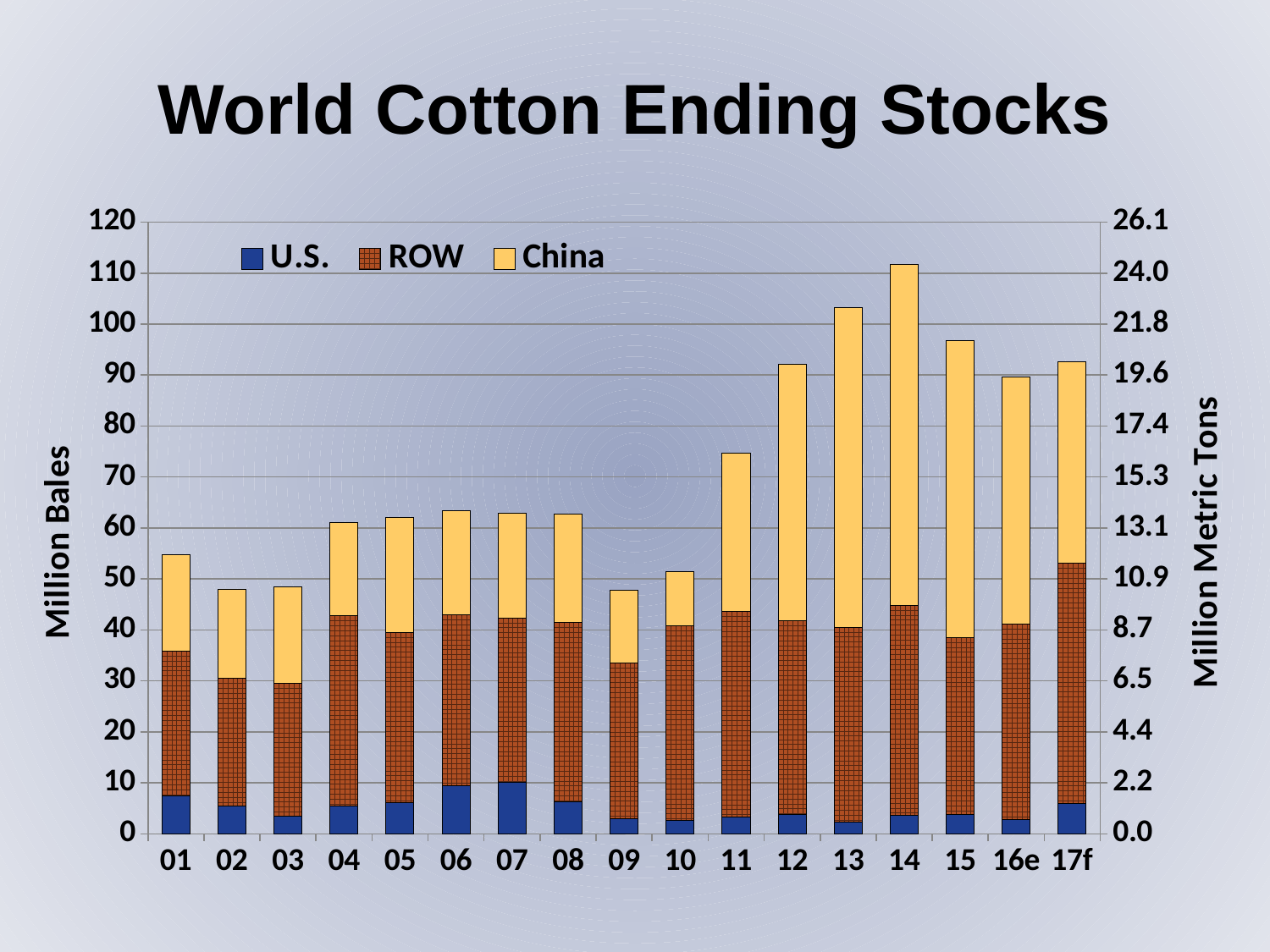
Which year has the highest total ending stocks? 14 Which year has the larger total ending stocks, 11 or 12? 12 Is the total ending stocks for 01 greater or less than 50 million bales? greater Which series is shown in yellow? China Is the total ending stocks for 11 greater or less than 70 million bales? greater How many years (bars) are plotted on the x axis? 17 Do total ending stocks rise or fall from 11 to 14? rise What kind of chart is shown on the slide? Stacked bar chart What is the label of the right-hand vertical axis? Million Metric Tons Is the total ending stocks for 14 greater or less than 100 million bales? greater How many series does the legend list? 3